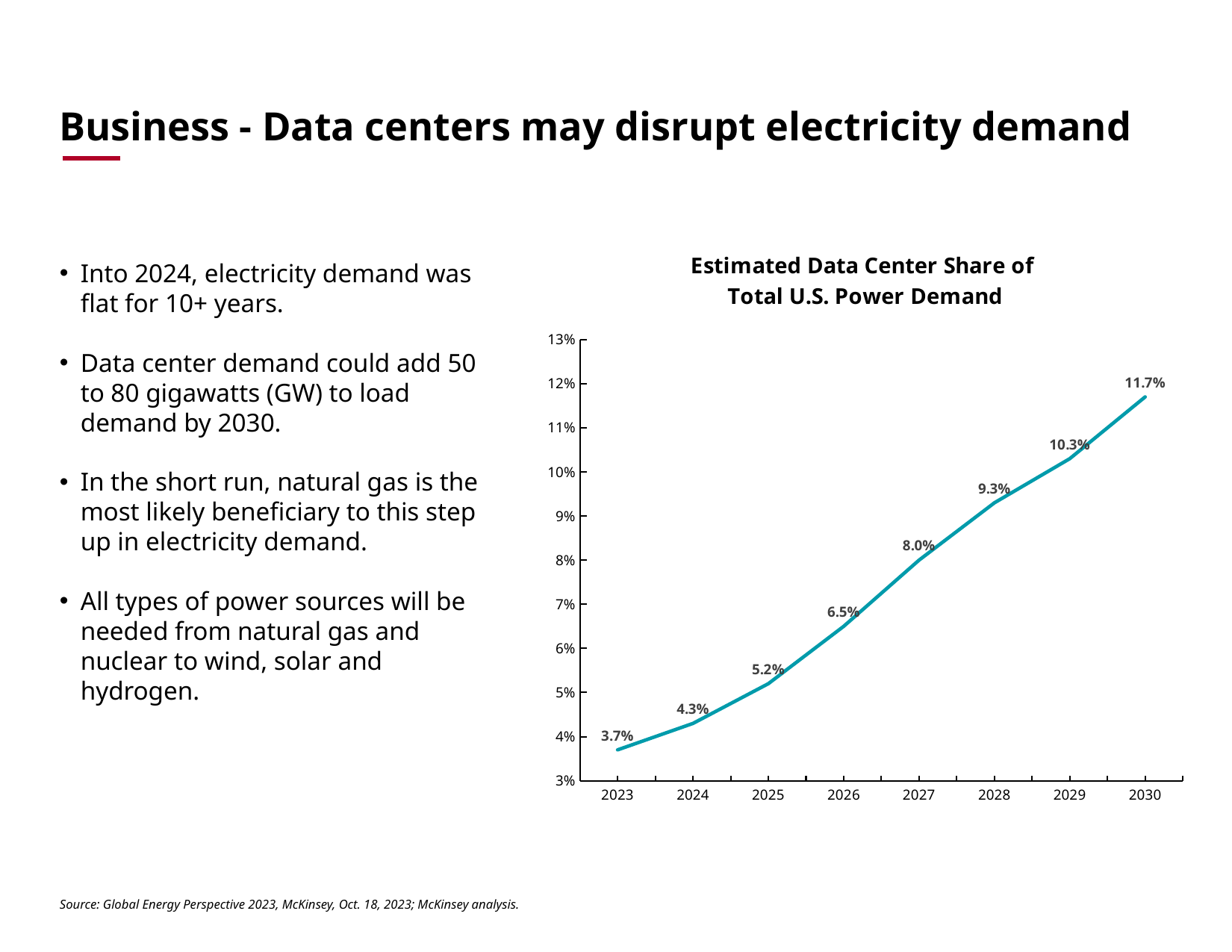
What is the estimated data center share of total U.S. power demand in 2023? 3.7% Is the value for 2028 greater or less than 9%? greater What kind of chart is shown on the slide? Line chart Which is larger, the value for 2026 or the value for 2025? 2026 How many years are plotted on the chart? 8 Do the values rise or fall from 2023 to 2030? Rise What is the estimated data center share of total U.S. power demand in 2027? 8.0% Which year has the highest estimated data center share of total U.S. power demand? 2030 What is the difference in percentage points between the 2030 and 2023 values? 8.0 percentage points What is the title of the chart? Estimated Data Center Share of Total U.S. Power Demand Which year has the lowest estimated data center share of total U.S. power demand? 2023 What is the estimated data center share of total U.S. power demand in 2030? 11.7%